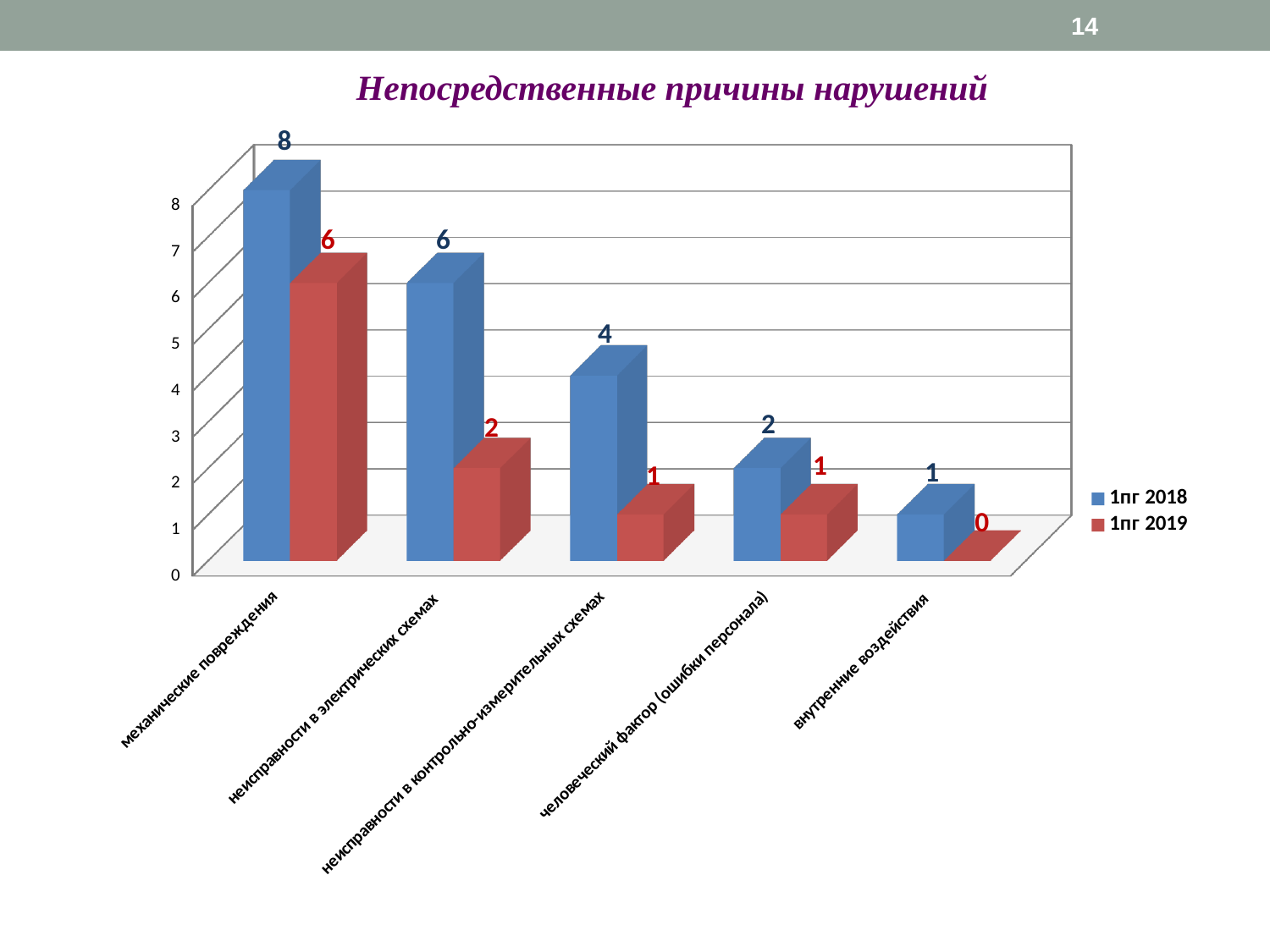
Which category has the lowest value in the 1пг 2019 series? внутренние воздействия Which is larger for неисправности в контрольно-измерительных схемах: the 1пг 2018 value or the 1пг 2019 value? 1пг 2018 How many categories are shown on the x axis? 5 What is the value for человеческий фактор (ошибки персонала) in the 1пг 2018 series? 2 What is the value for неисправности в электрических схемах in the 1пг 2019 series? 2 What is the difference between the 1пг 2018 and 1пг 2019 values for неисправности в электрических схемах? 4 What is the value for внутренние воздействия in the 1пг 2019 series? 0 What kind of chart is shown on the slide? bar chart What is the title of the chart? Непосредственные причины нарушений Which category has the highest value in the 1пг 2018 series? механические повреждения How many series does the legend list? 2 What is the value for механические повреждения in the 1пг 2018 series? 8